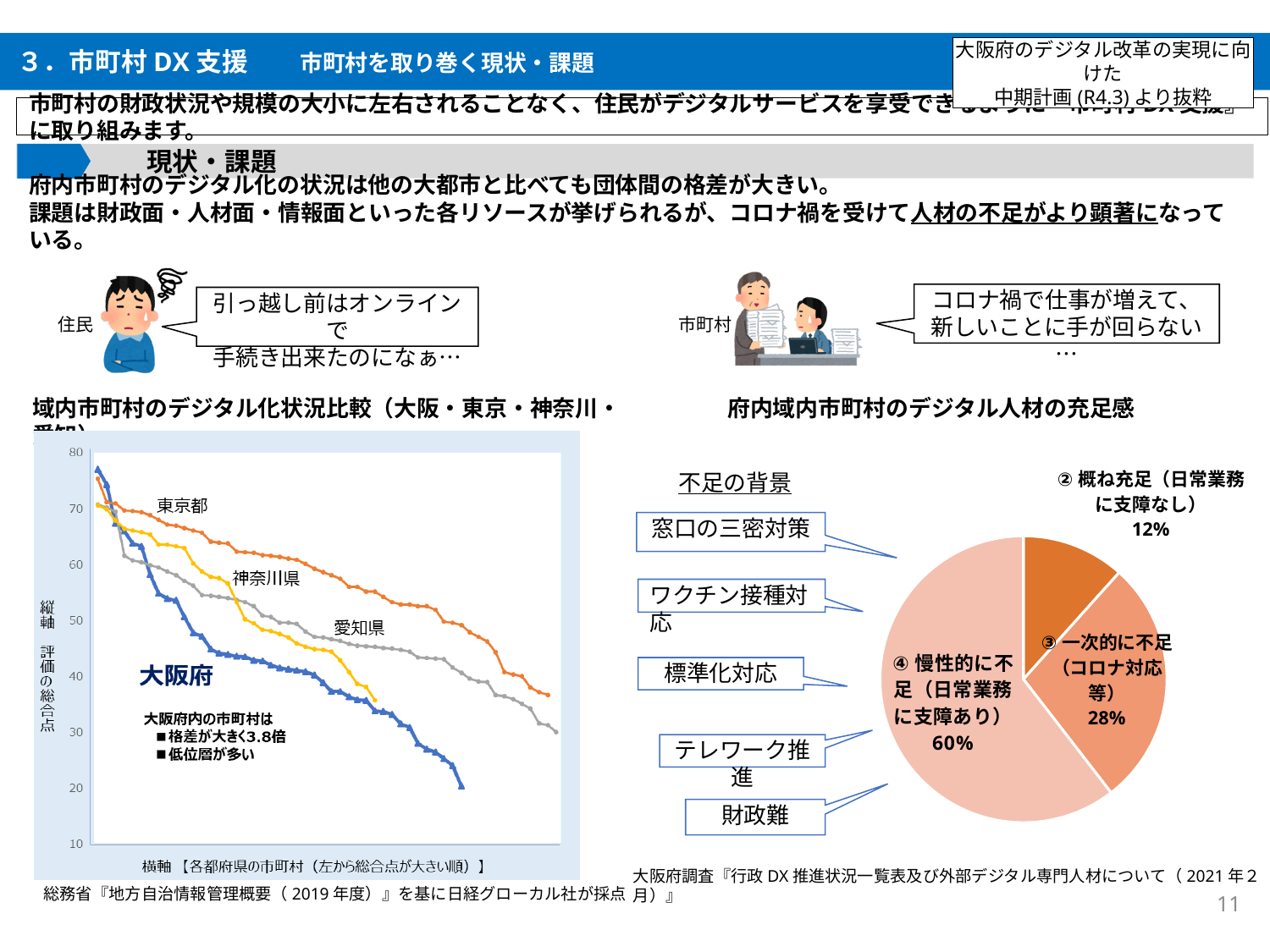
In the line chart on the left, do the values rise or fall from left to right along the x axis? Fall In the pie chart on the right, what is the difference in percentage points between ④ 慢性的に不足 and ③ 一次的に不足? 32 percentage points What kind of chart is shown on the left side of the slide (域内市町村のデジタル化状況比較)? Line chart In the pie chart on the right, how many slices are there? 3 In the pie chart on the right, what share is labelled ② 概ね充足（日常業務に支障なし）? 12% What kind of chart is shown on the right side of the slide? Pie chart In the pie chart on the right, which category has the largest share? ④ 慢性的に不足（日常業務に支障あり） In the pie chart on the right, which category has the smallest share? ② 概ね充足（日常業務に支障なし） In the line chart on the left, how many prefectures (series) are plotted? 4 In the pie chart on the right (府内域内市町村のデジタル人材の充足感), what share is labelled ④ 慢性的に不足（日常業務に支障あり）? 60% In the pie chart on the right, what share is labelled ③ 一次的に不足（コロナ対応等）? 28% In the line chart on the left, is the lowest point of the 大阪府 line greater or less than 30? less